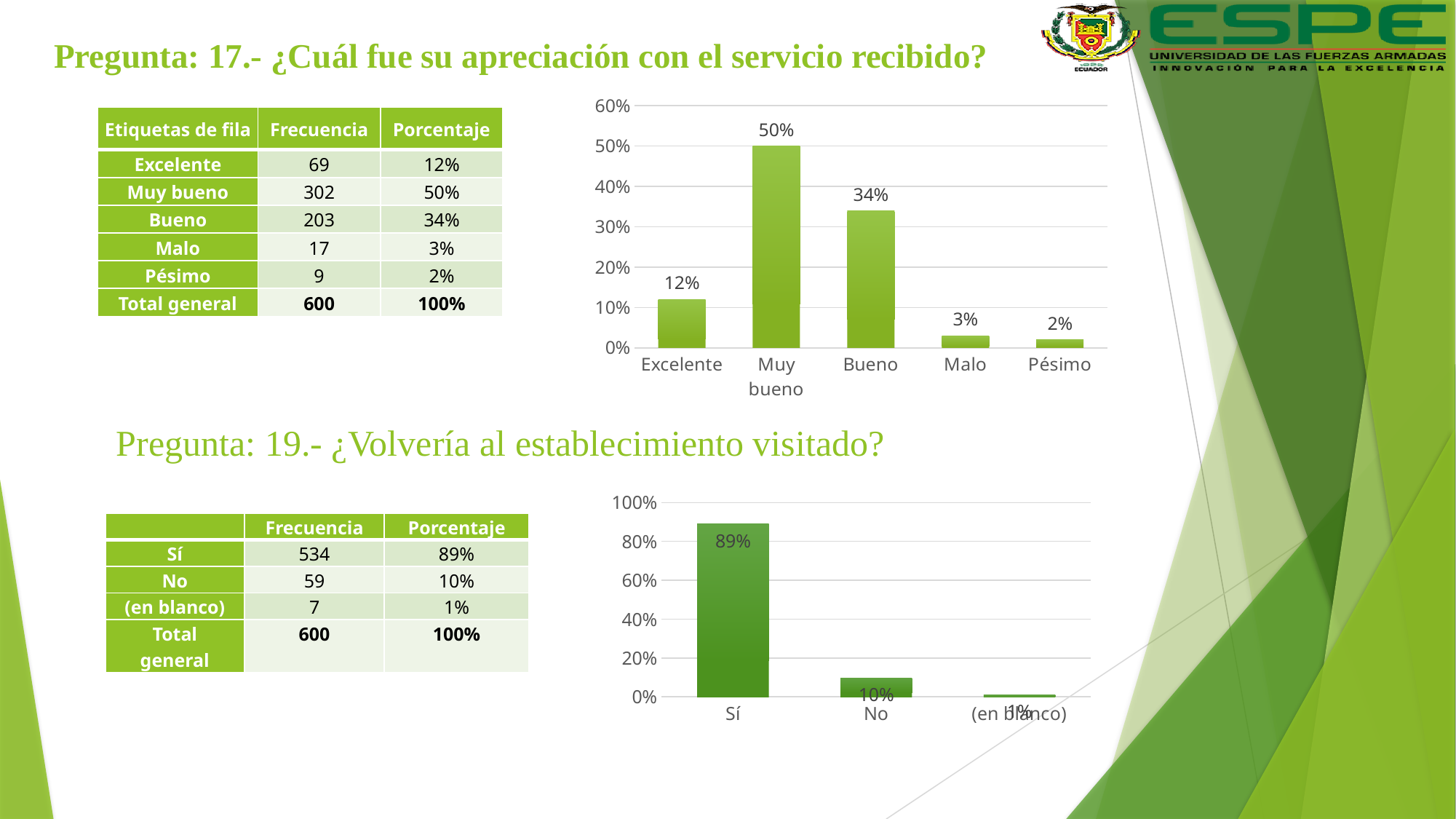
In the bottom chart (Pregunta 19), what is the value for Sí? 89% What kind of chart is the top chart (Pregunta 17)? Bar chart In the top chart (Pregunta 17), which category has the highest value? Muy bueno In the bottom chart (Pregunta 19), which category has the highest value? Sí In the top chart (Pregunta 17), what is the value for Bueno? 34% In the top chart (Pregunta 17), what is the value for Muy bueno? 50% In the bottom chart (Pregunta 19), how many categories are shown on the x axis? 3 In the top chart (Pregunta 17), which is larger, the value for Excelente or the value for Malo? Excelente In the top chart (Pregunta 17), how many categories are shown on the x axis? 5 In the top chart (Pregunta 17), what is the difference between the values for Muy bueno and Bueno? 16% In the top chart (Pregunta 17), which category has the lowest value? Pésimo In the bottom chart (Pregunta 19), what is the value for No? 10%